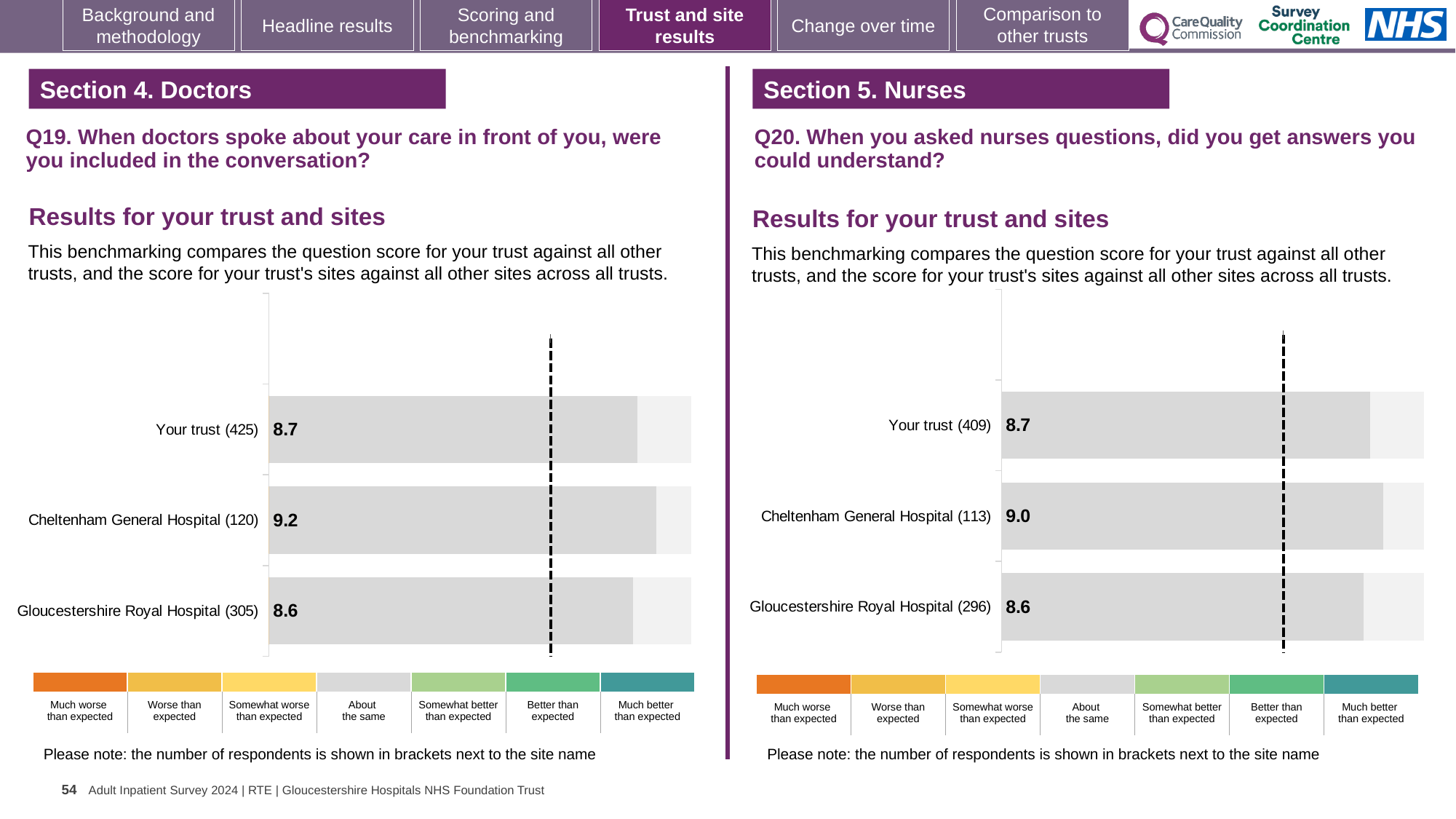
What type of chart is used on the right (Q20, nurses)? Bar chart On the right chart (Q20, nurses), what is the difference between the scores for Cheltenham General Hospital and Your trust? 0.3 On the right chart (Q20, nurses), which site or trust has the lowest score? Gloucestershire Royal Hospital On the left chart (Q19, doctors), what is the difference between the scores for Cheltenham General Hospital and Gloucestershire Royal Hospital? 0.6 On the right chart (Q20, nurses), what is the score for Gloucestershire Royal Hospital? 8.6 On the left chart (Q19, doctors), what is the score for Your trust? 8.7 On the right chart (Q20, nurses), which has the larger score: Your trust or Gloucestershire Royal Hospital? Your trust On the right chart (Q20, nurses), what is the score for Cheltenham General Hospital? 9.0 On the left chart (Q19, doctors), which site or trust has the highest score? Cheltenham General Hospital How many bars are plotted on the left chart (Q19, doctors)? 3 On the left chart (Q19, doctors), what is the score for Cheltenham General Hospital? 9.2 On the left chart (Q19, doctors), how many respondents are shown in brackets for Gloucestershire Royal Hospital? 305